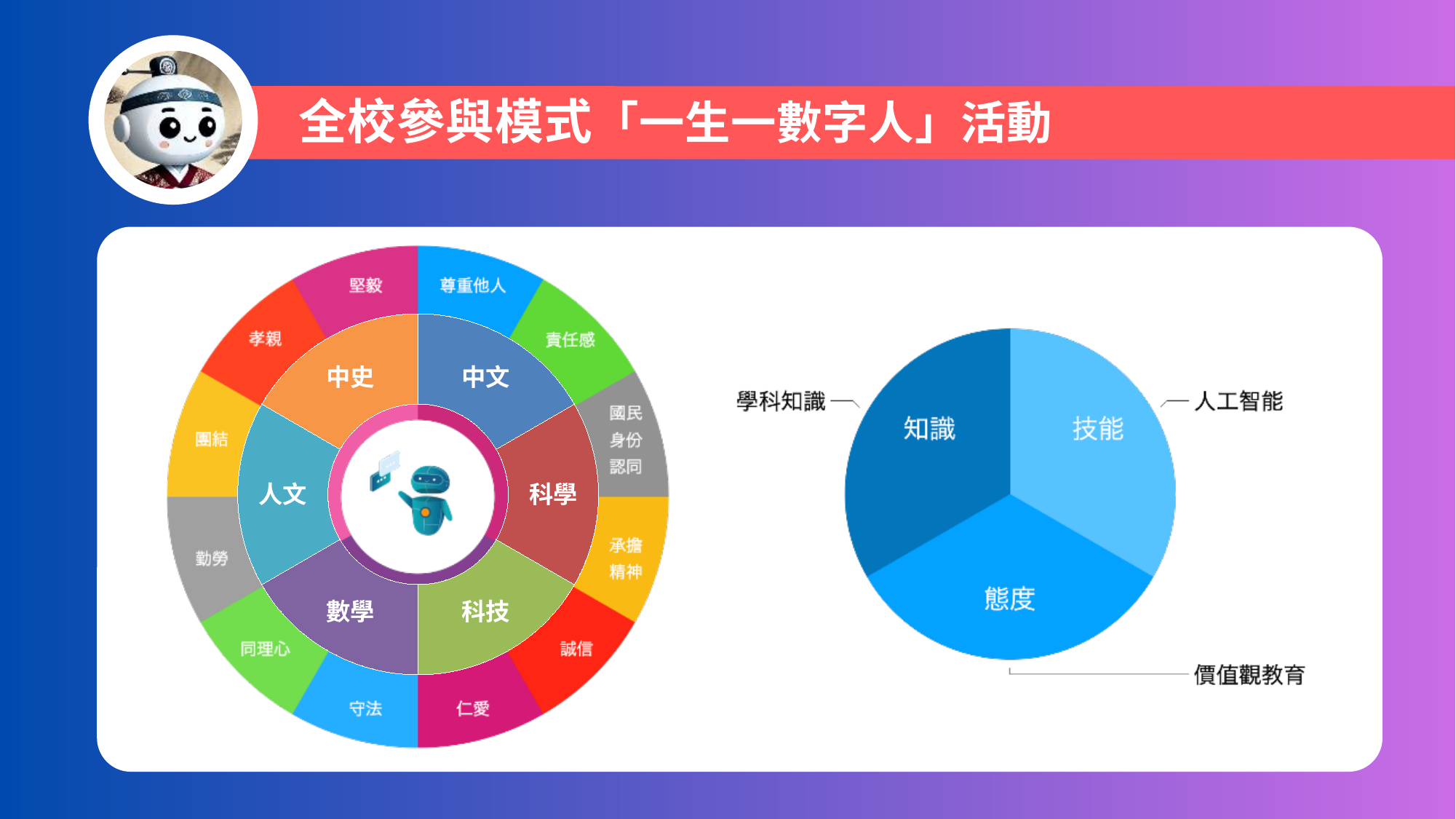
In the pie chart on the right side of the slide, which slice is annotated with the label 人工智能? 技能 What kind of chart is the chart on the right side of the slide? pie chart In the pie chart on the right side of the slide, which slice is annotated with the label 價值觀教育? 態度 How many segments are in the outer ring of the circular diagram on the left side of the slide? 12 How many subject segments are in the inner ring of the circular diagram on the left side of the slide? 6 In the circular diagram on the left side of the slide, which inner-ring subject segment is directly opposite 中文? 數學 How many slices does the pie chart on the right side of the slide have? 3 In the pie chart on the right side of the slide, what is the label of the darkest blue slice? 知識